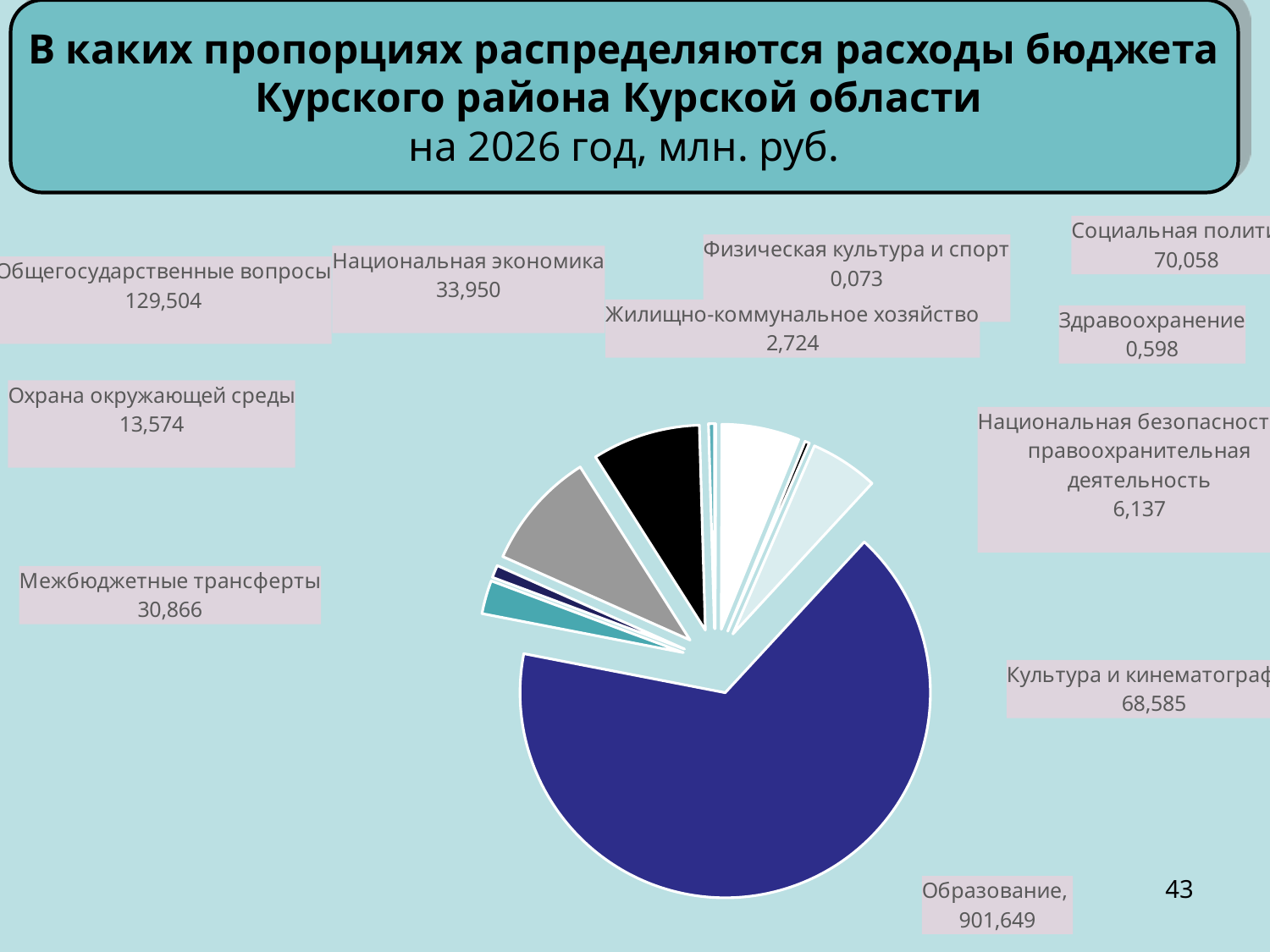
Which category has the smallest value? Физическая культура и спорт In what units are the values on the slide expressed, according to the title? млн. руб. What kind of chart is shown on the slide? pie chart What is the value for Национальная экономика? 33,950 Which category has the largest value? Образование How many categories are shown in the pie chart? 11 What is the difference between Общегосударственные вопросы and Национальная экономика? 95,554 What is the value for Общегосударственные вопросы? 129,504 Which is larger: Межбюджетные трансферты or Охрана окружающей среды? Межбюджетные трансферты What is the value for Образование? 901,649 What is the value for Жилищно-коммунальное хозяйство? 2,724 What is the value for Здравоохранение? 0,598